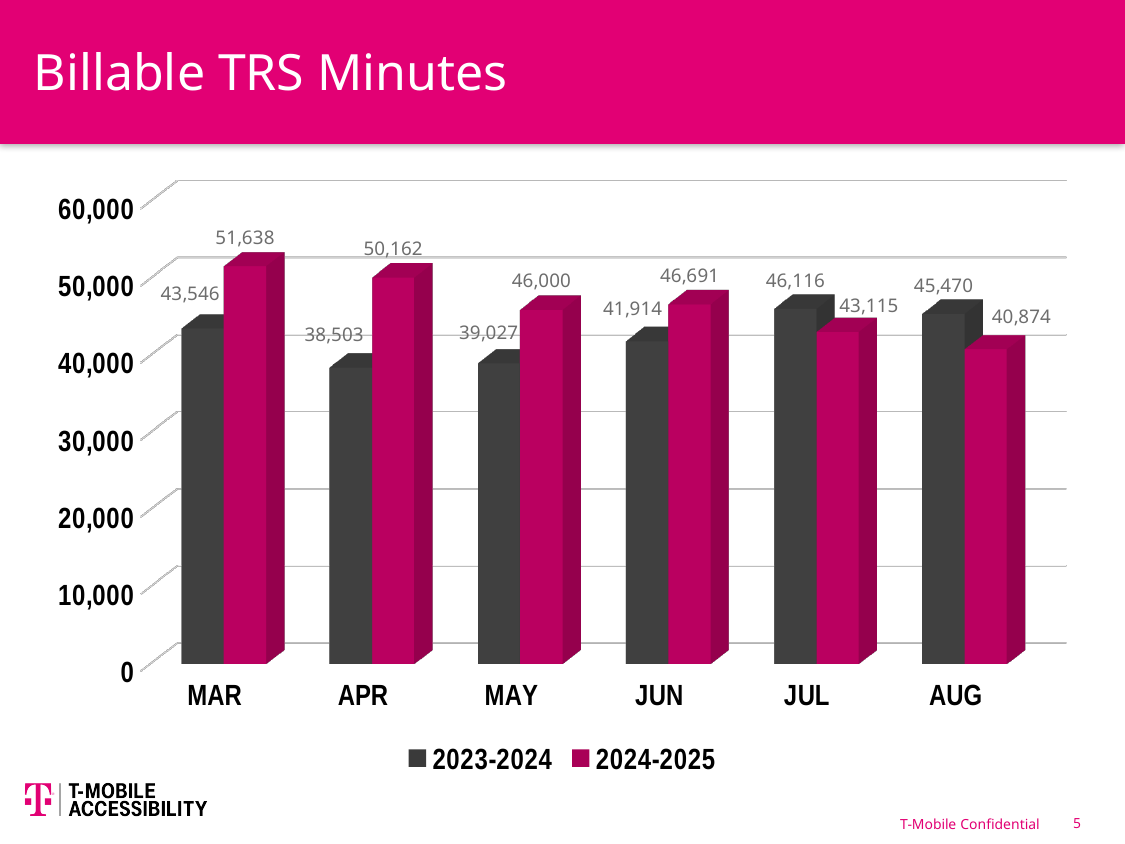
Which month has the highest value in the 2024-2025 series? MAR What is the value for AUG in the 2024-2025 series? 40,874 What is the title of the chart? Billable TRS Minutes What is the value for MAR in the 2024-2025 series? 51,638 What is the value for APR in the 2023-2024 series? 38,503 What kind of chart is shown on the slide? bar chart Which is larger for JUL: the 2023-2024 value or the 2024-2025 value? 2023-2024 Is the value for MAY in the 2023-2024 series greater or less than 40,000? less Which month has the lowest value in the 2023-2024 series? APR How many series does the legend list? 2 How many months are shown on the x axis? 6 What is the difference between the 2024-2025 and 2023-2024 values for MAR? 8,092